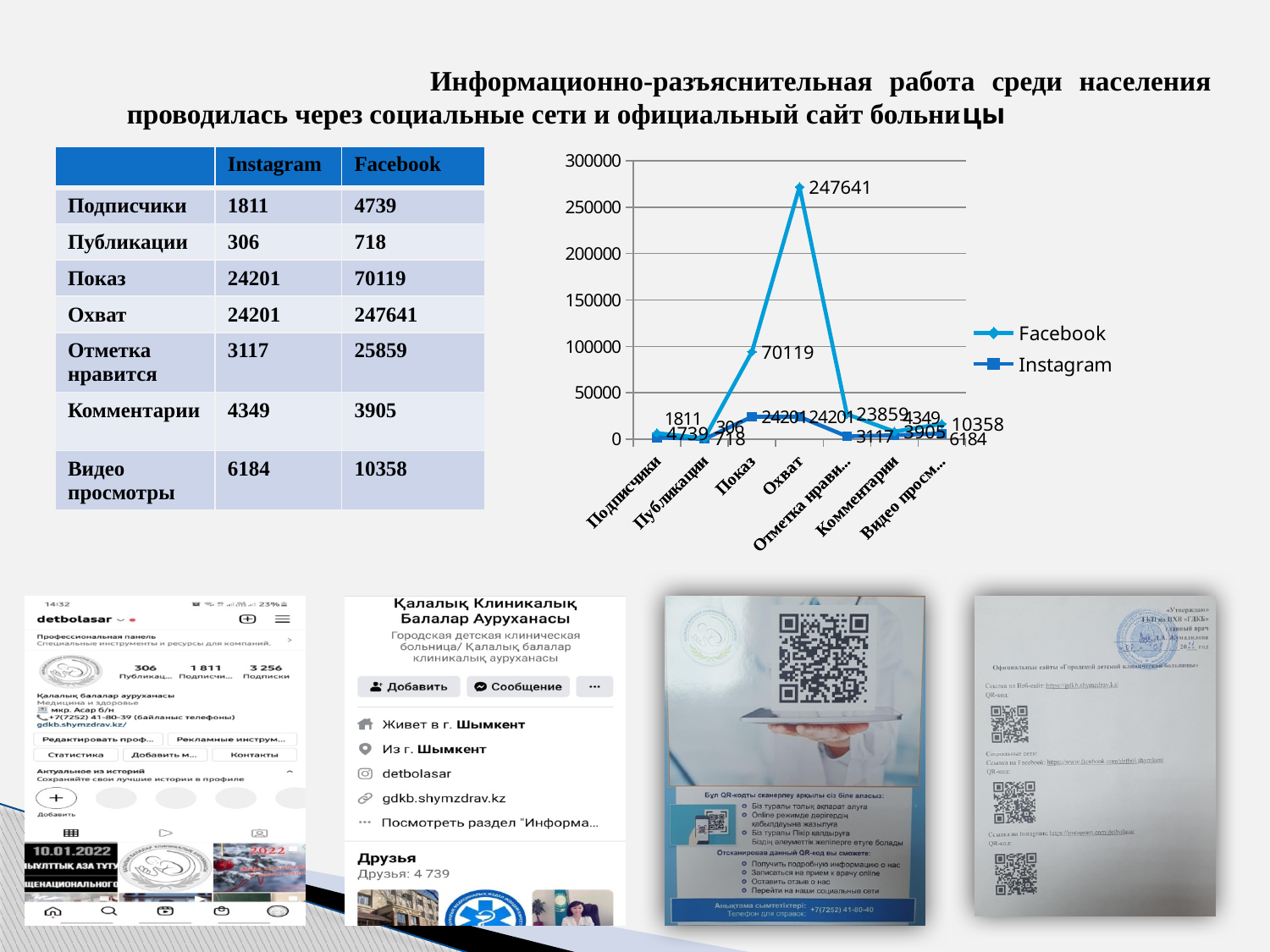
Which is larger in the chart: the Facebook value for Показ or the Instagram value for Показ? Facebook What is the Facebook value for Охват in the chart? 247641 How many series does the chart legend list? 2 What is the Facebook value for Показ in the chart? 70119 What is the Facebook value for Видео просмотры in the chart? 10358 What is the difference between the Facebook and Instagram values for Показ in the chart? 45918 Which series in the chart legend is shown with square markers? Instagram Is the Facebook value for Охват greater or less than 200000? greater What is the Instagram value for Подписчики in the chart? 1811 How many categories are plotted along the x axis of the chart? 7 What type of chart is shown on the slide? line chart Which category has the highest Facebook value in the chart? Охват